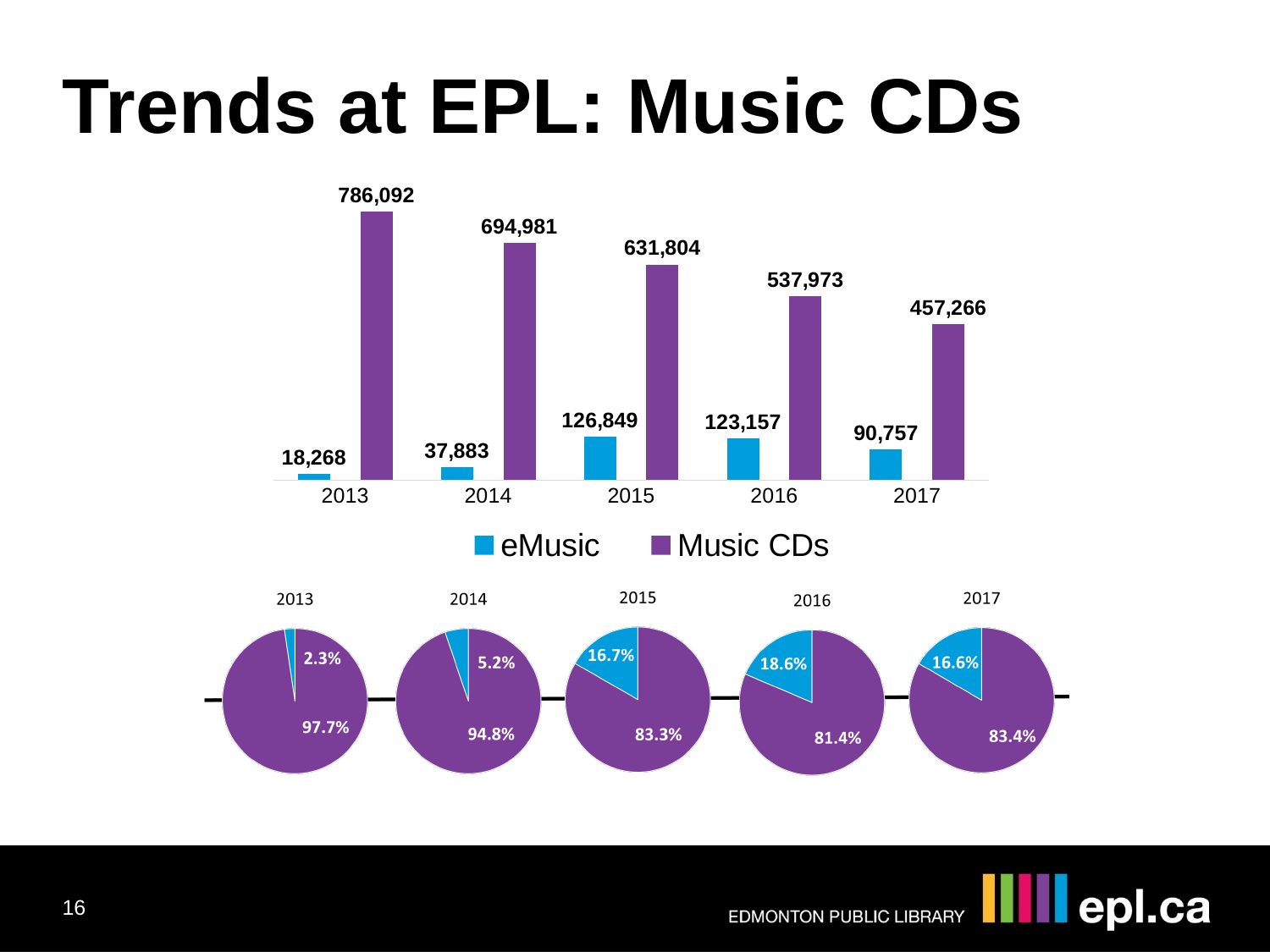
How many series does the bar chart's legend list? 2 In the bar chart, what is the value for eMusic in 2017? 90,757 In the bar chart, by how much did Music CDs fall from 2013 to 2017? 328,826 In the bar chart, do the Music CDs values rise or fall from 2013 to 2017? fall In the bar chart, which year has the lowest Music CDs value? 2017 In the bar chart, which is larger: eMusic in 2016 or eMusic in 2017? eMusic in 2016 In the bar chart, what is the value for Music CDs in 2013? 786,092 In the 2013 pie chart at the bottom, what share does the purple (Music CDs) slice have? 97.7% In the bar chart, which year has the highest eMusic value? 2015 In the 2016 pie chart at the bottom, what share does the blue (eMusic) slice have? 18.6% In the bar chart, what is the difference between Music CDs and eMusic in 2017? 366,509 In the bar chart, what is the value for eMusic in 2015? 126,849